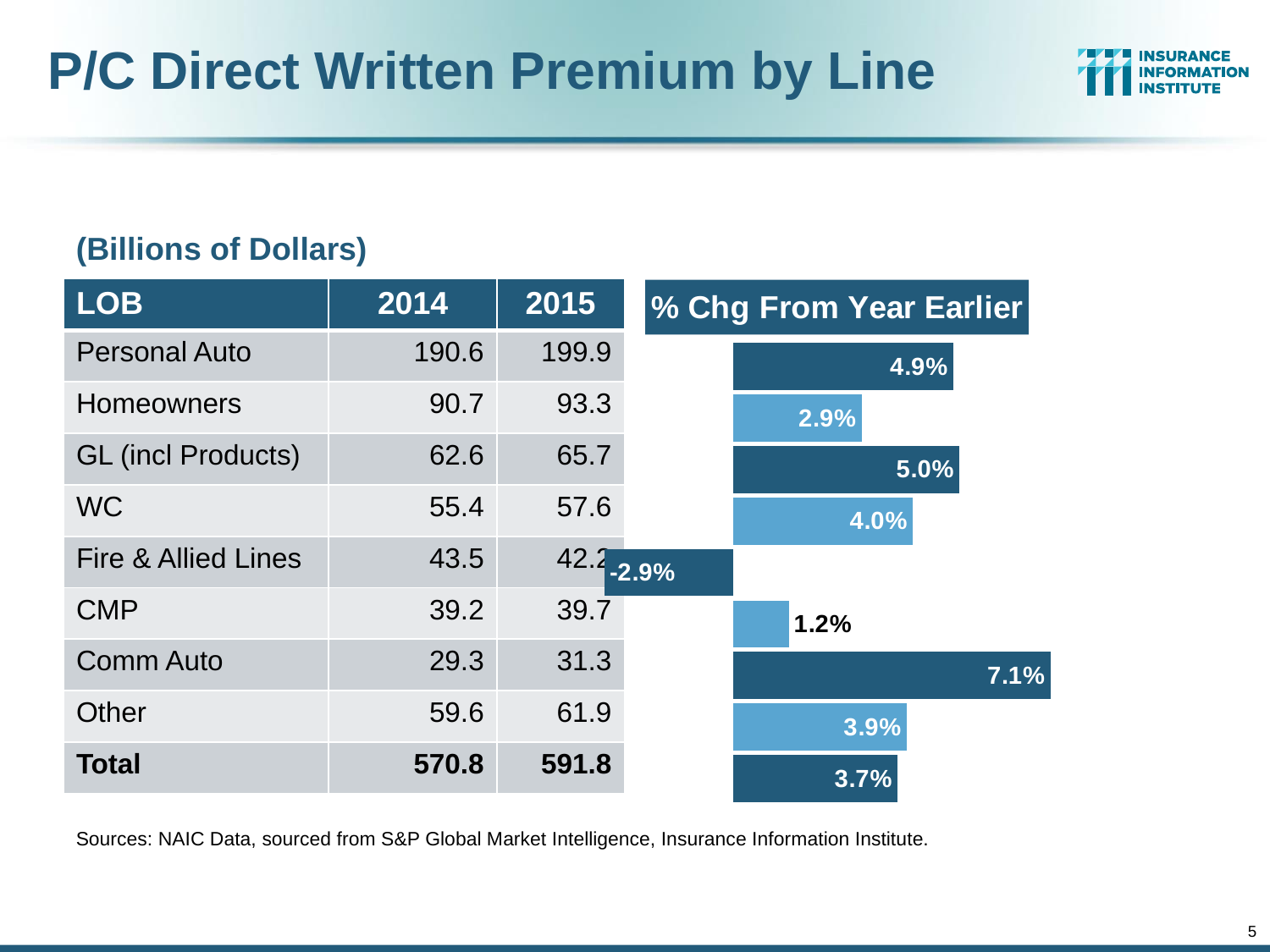
In the '% Chg From Year Earlier' chart, how many bars show a negative value? 1 In the '% Chg From Year Earlier' chart, what is the value for Fire & Allied Lines? -2.9% What is the title of the chart on the slide? % Chg From Year Earlier In the '% Chg From Year Earlier' chart, which line of business has the lowest percentage change? Fire & Allied Lines In the '% Chg From Year Earlier' chart, what is the value for Personal Auto? 4.9% What kind of chart is the '% Chg From Year Earlier' chart? Bar chart In the '% Chg From Year Earlier' chart, which is larger, the value for GL (incl Products) or the value for WC? GL (incl Products) In the '% Chg From Year Earlier' chart, how many bars are plotted? 9 In the '% Chg From Year Earlier' chart, which line of business has the highest percentage change? Comm Auto In the '% Chg From Year Earlier' chart, what is the value for the Total row? 3.7% In the '% Chg From Year Earlier' chart, what is the difference between the values for Comm Auto and Homeowners? 4.2% In the '% Chg From Year Earlier' chart, what is the value for Comm Auto? 7.1%